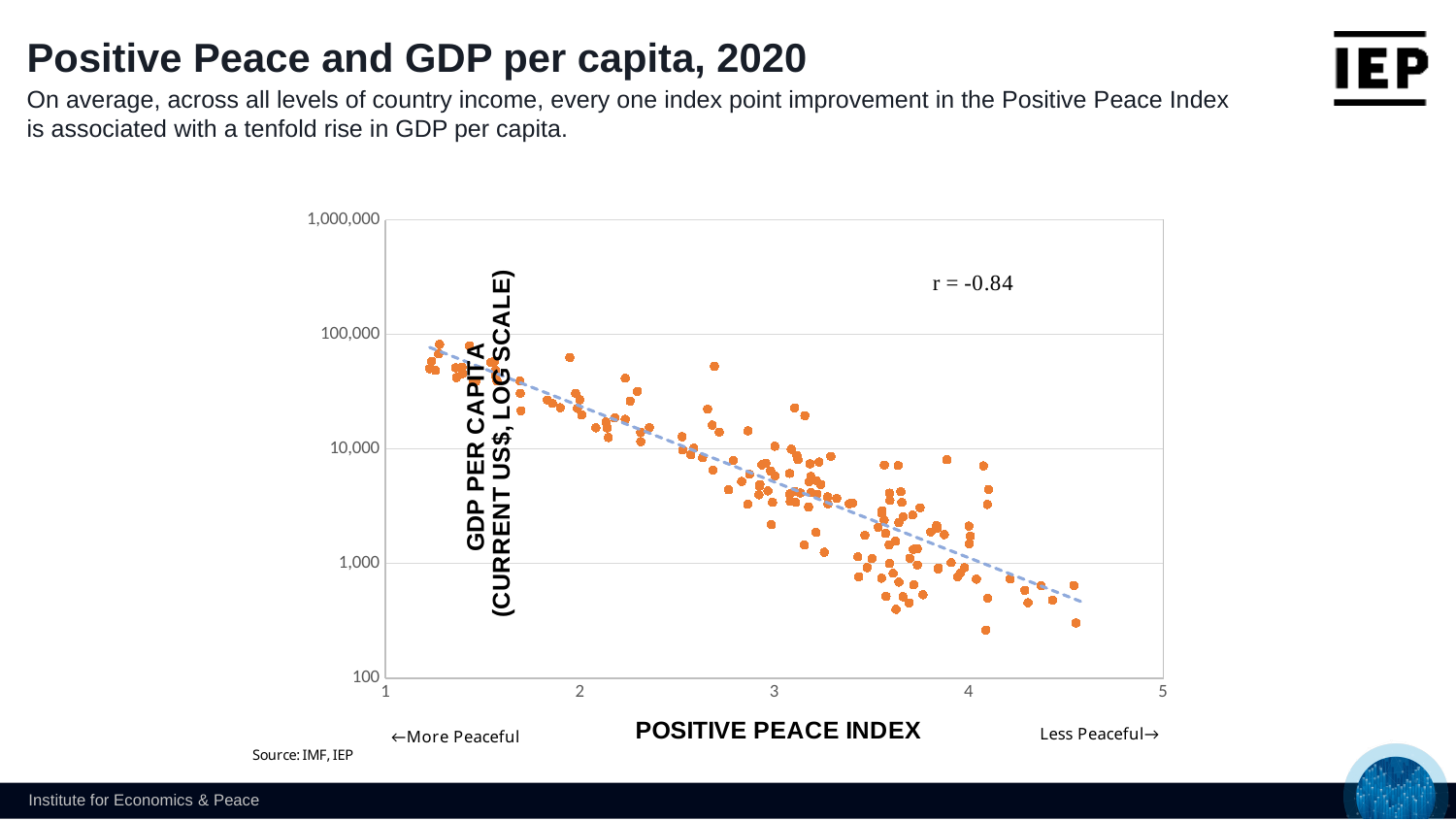
As the Positive Peace Index increases along the x axis, does GDP per capita rise or fall? Fall What is the title of the chart on the slide? Positive Peace and GDP per capita, 2020 What is the lowest tick value shown on the x axis? 1 Is the highest GDP per capita value plotted on the chart greater or less than 100,000? less What kind of chart is shown on the slide? Scatter plot What is the highest tick value shown on the y axis? 1,000,000 Is the lowest GDP per capita value plotted on the chart greater or less than 1,000? less What is the label of the y axis of the chart? GDP PER CAPITA (CURRENT US$, LOG SCALE) What is the correlation coefficient (r) printed on the chart? r = -0.84 Are the GDP per capita values for countries with a Positive Peace Index near 1.3 greater or less than 10,000? greater